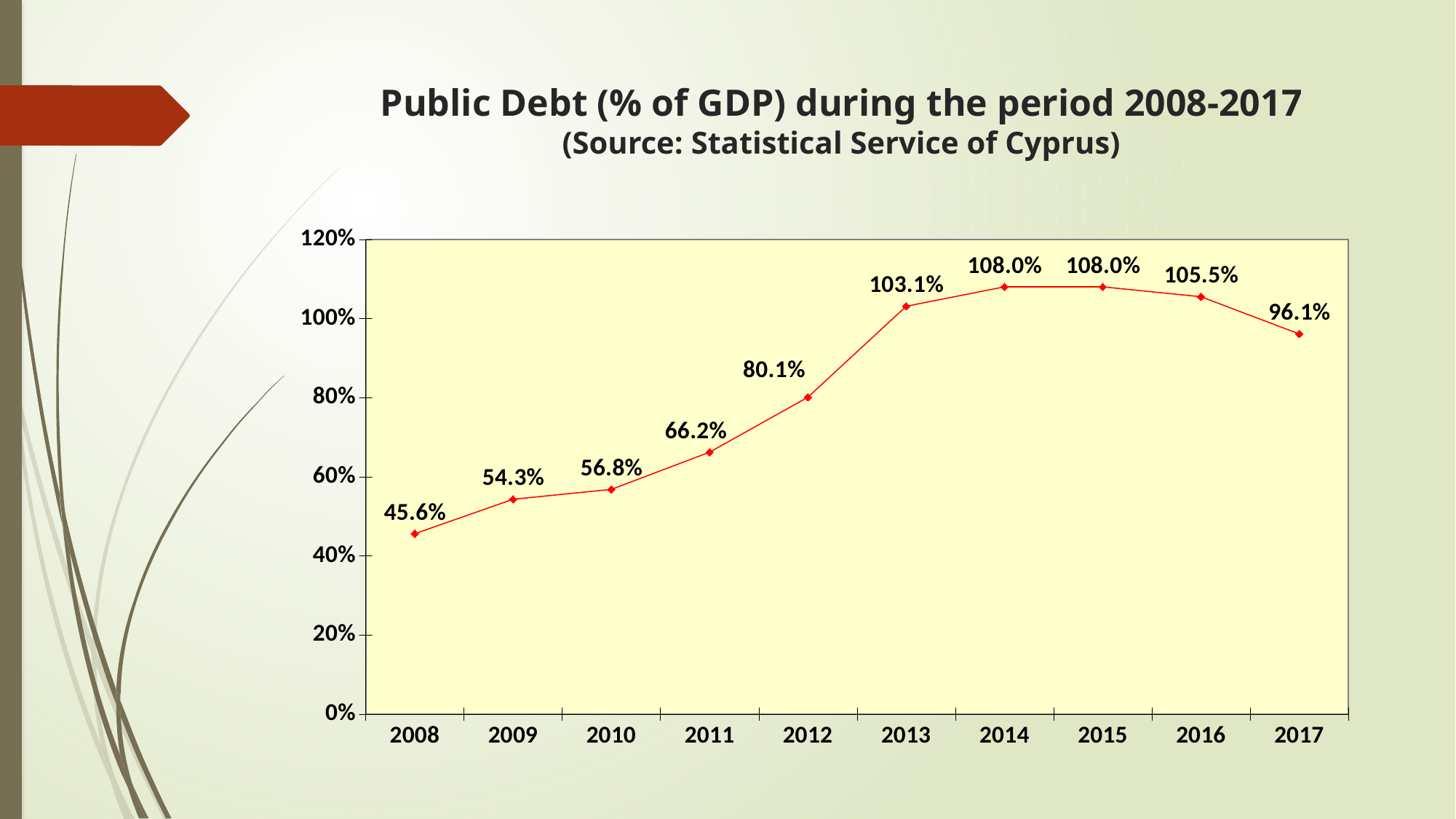
How many years are plotted on the chart? 10 What is the difference between the public debt values for 2012 and 2011? 13.9% Which year has a higher public debt value, 2010 or 2012? 2012 What was the public debt as a percentage of GDP in 2013? 103.1% Does the public debt rise or fall from 2008 to 2014? Rise Is the value for 2014 greater or less than 100%? greater What kind of chart is shown on the slide? Line chart What was the public debt as a percentage of GDP in 2008? 45.6% What is the highest value of public debt shown on the chart? 108.0% What is the difference between the public debt values for 2016 and 2017? 9.4% What was the public debt as a percentage of GDP in 2017? 96.1% Which year shows the lowest public debt as a percentage of GDP? 2008